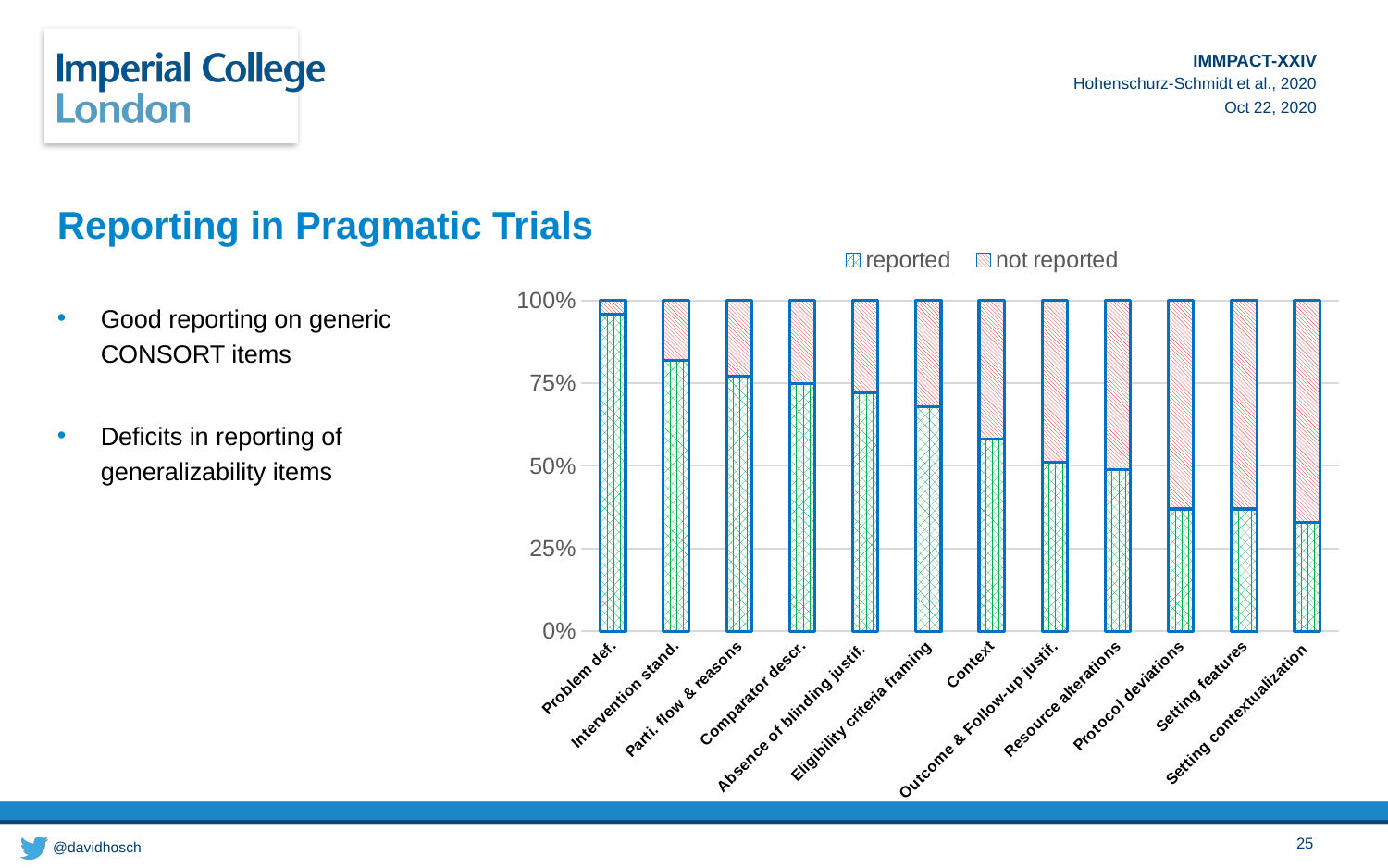
What kind of chart is shown on the slide? stacked bar chart How many series does the chart legend list? 2 Which category has the highest reported share? Problem def. Is the reported share for Eligibility criteria framing greater or less than 50%? greater What are the two series named in the chart legend? reported, not reported Do the reported shares rise or fall moving from left to right along the x axis? fall Is the reported share for Protocol deviations greater or less than 50%? less Is the reported share for Intervention stand. greater or less than 75%? greater How many categories are shown on the x axis of the chart? 12 Which has a larger reported share, Intervention stand. or Context? Intervention stand.